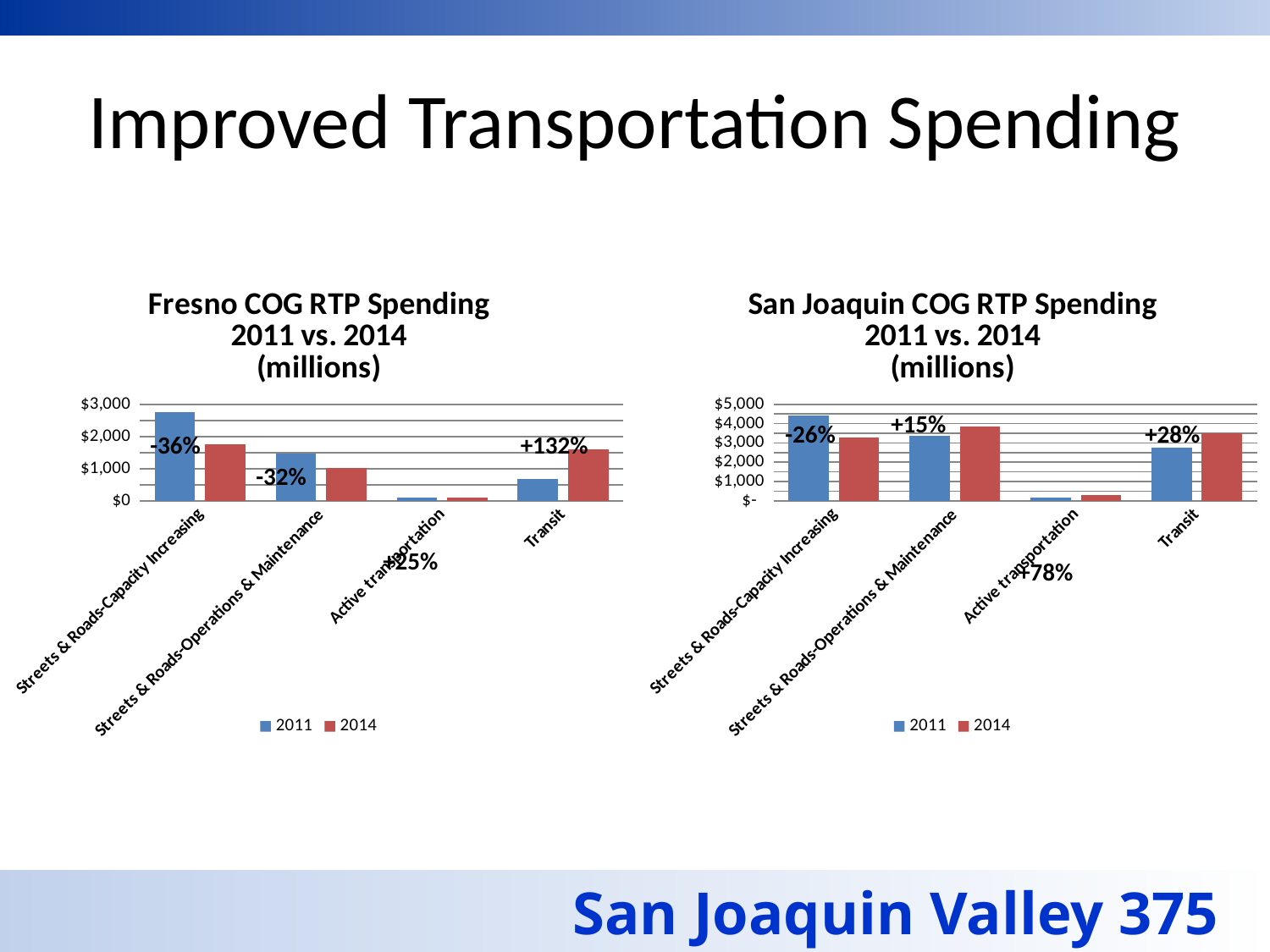
In the Fresno COG RTP Spending chart, which is larger for Transit: the 2011 value or the 2014 value? 2014 How many series does the legend of the San Joaquin COG RTP Spending chart list? 2 In the Fresno COG RTP Spending chart, what percentage change is labelled for Streets & Roads-Capacity Increasing? -36% In the San Joaquin COG RTP Spending chart, what percentage change is labelled for Active transportation? +78% In the Fresno COG RTP Spending chart, is the 2011 value for Streets & Roads-Capacity Increasing greater or less than $2,000? greater In the Fresno COG RTP Spending chart, which category has the highest 2011 value? Streets & Roads-Capacity Increasing In the San Joaquin COG RTP Spending chart, is the 2014 value for Streets & Roads-Capacity Increasing greater or less than $4,000? less What type of chart is the Fresno COG RTP Spending chart? bar chart How many categories are shown on the x axis of the Fresno COG RTP Spending chart? 4 In the San Joaquin COG RTP Spending chart, which category has the lowest 2014 value? Active transportation In the San Joaquin COG RTP Spending chart, what percentage change is labelled for Streets & Roads-Operations & Maintenance? +15% In the Fresno COG RTP Spending chart, what percentage change is labelled for Transit? +132%